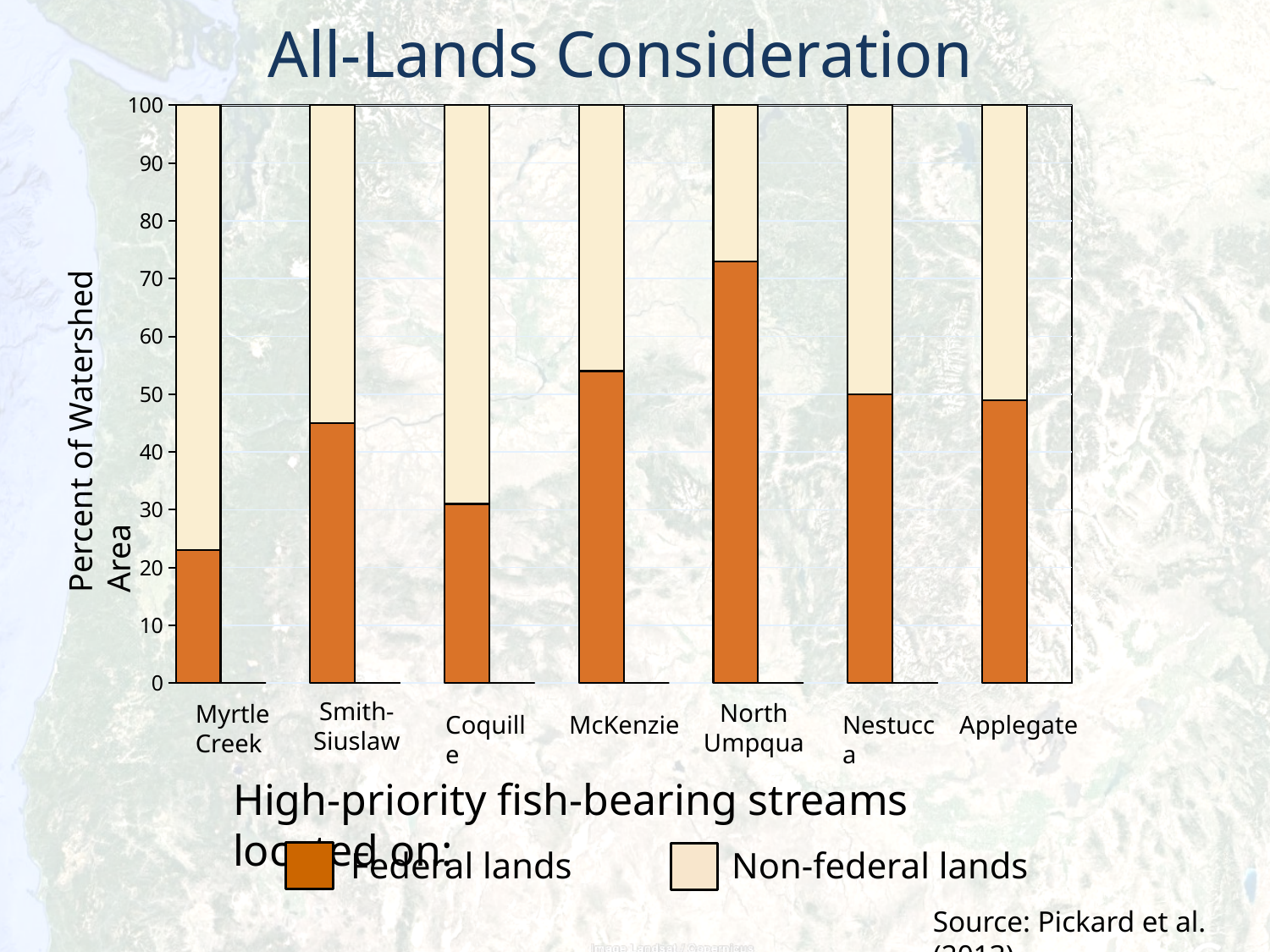
What kind of chart is shown on the slide? bar chart Which has a larger non-federal lands share, Myrtle Creek or North Umpqua? Myrtle Creek What is the total height of each stacked bar on the y axis? 100 Which watershed has the highest percentage of high-priority fish-bearing streams on federal lands? North Umpqua Which has a larger federal lands share, McKenzie or Smith-Siuslaw? McKenzie How many watersheds are shown along the x axis? 7 Which watershed has the lowest percentage of high-priority fish-bearing streams on federal lands? Myrtle Creek Is the federal lands value for Myrtle Creek greater or less than 30? less What is the label on the y axis? Percent of Watershed Area How many series does the legend list? 2 Is the federal lands value for Coquille greater or less than 40? less Is the federal lands value for North Umpqua greater or less than 70? greater